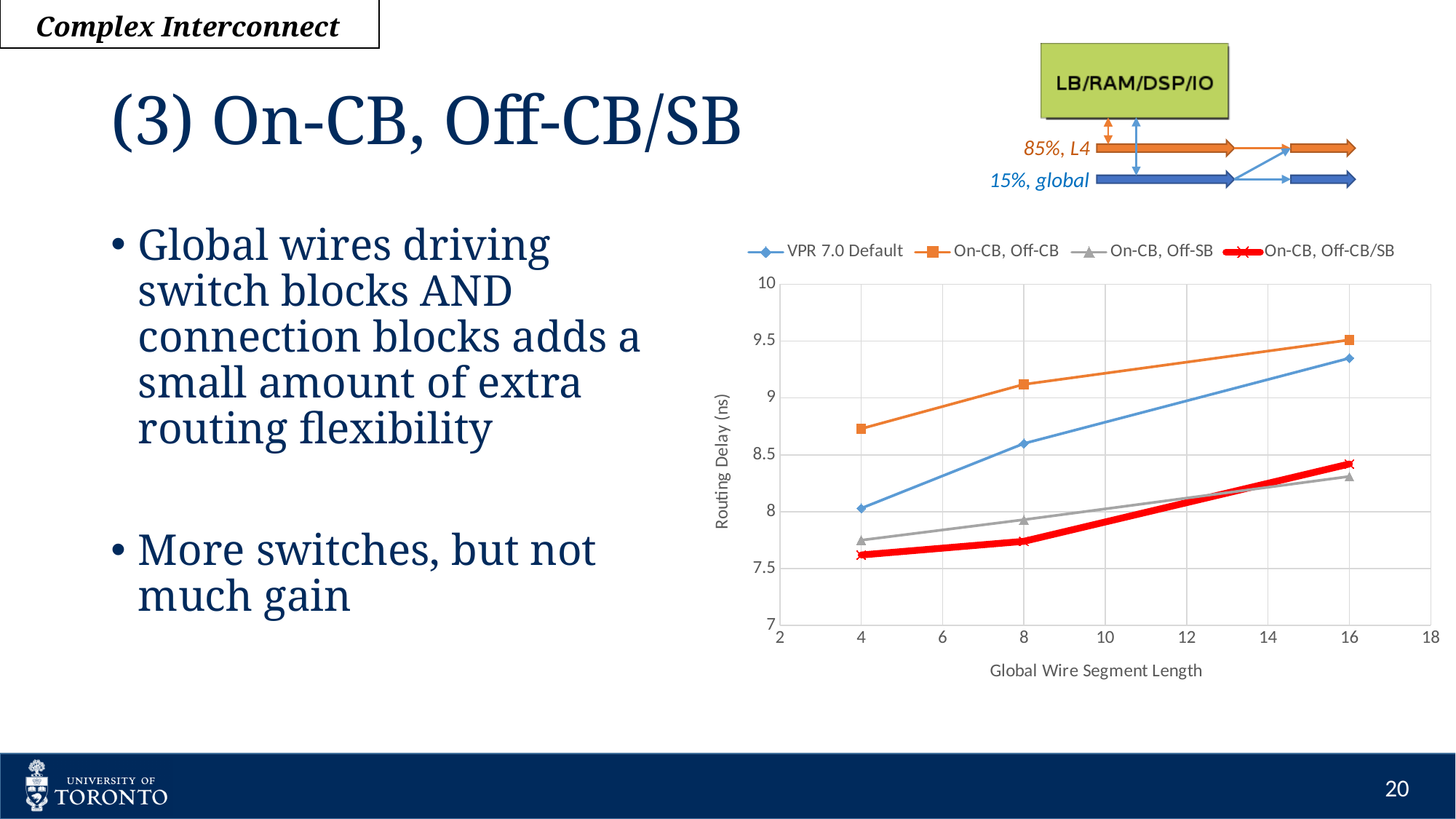
What kind of chart is shown on the slide? Line chart Which series has the highest routing delay at a global wire segment length of 4? On-CB, Off-CB How many series does the chart legend list? 4 Does the routing delay for the On-CB, Off-CB/SB series rise or fall as global wire segment length increases? Rises Which series has the lowest routing delay at a global wire segment length of 4? On-CB, Off-CB/SB At a global wire segment length of 8, which has the larger routing delay: On-CB, Off-SB or On-CB, Off-CB/SB? On-CB, Off-SB Is the routing delay for On-CB, Off-CB/SB at a global wire segment length of 8 greater or less than 8? less How many data points are plotted for the VPR 7.0 Default series? 3 What is the label of the y axis of the chart? Routing Delay (ns) At a global wire segment length of 8, which has the larger routing delay: VPR 7.0 Default or On-CB, Off-CB? On-CB, Off-CB Which series has the highest routing delay at a global wire segment length of 16? On-CB, Off-CB Is the routing delay for VPR 7.0 Default at a global wire segment length of 16 greater or less than 9? greater